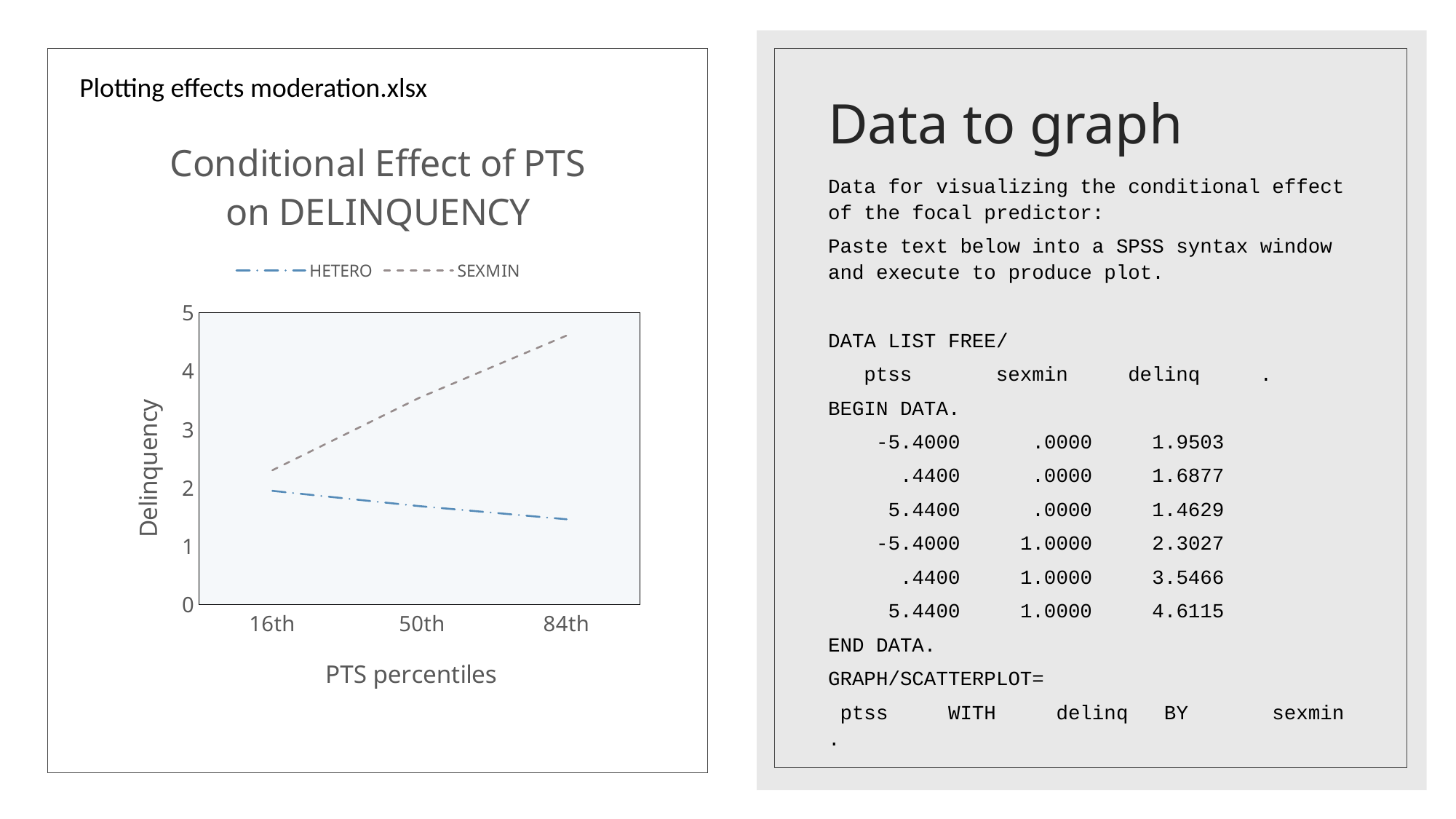
Does the HETERO line rise or fall from the 16th to the 84th percentile? fall Does the SEXMIN line rise or fall from the 16th to the 84th percentile? rise At the 84th percentile, which series has the higher Delinquency value, HETERO or SEXMIN? SEXMIN Is the SEXMIN value at the 50th percentile greater or less than 3? greater What is the title of the chart? Conditional Effect of PTS on DELINQUENCY How many series does the chart legend list? 2 What kind of chart is shown on the slide? line chart How many PTS percentile categories are shown on the x axis? 3 What is the label of the chart's y axis? Delinquency Is the SEXMIN value at the 84th percentile greater or less than 4? greater Is the HETERO value at the 50th percentile greater or less than 2? less